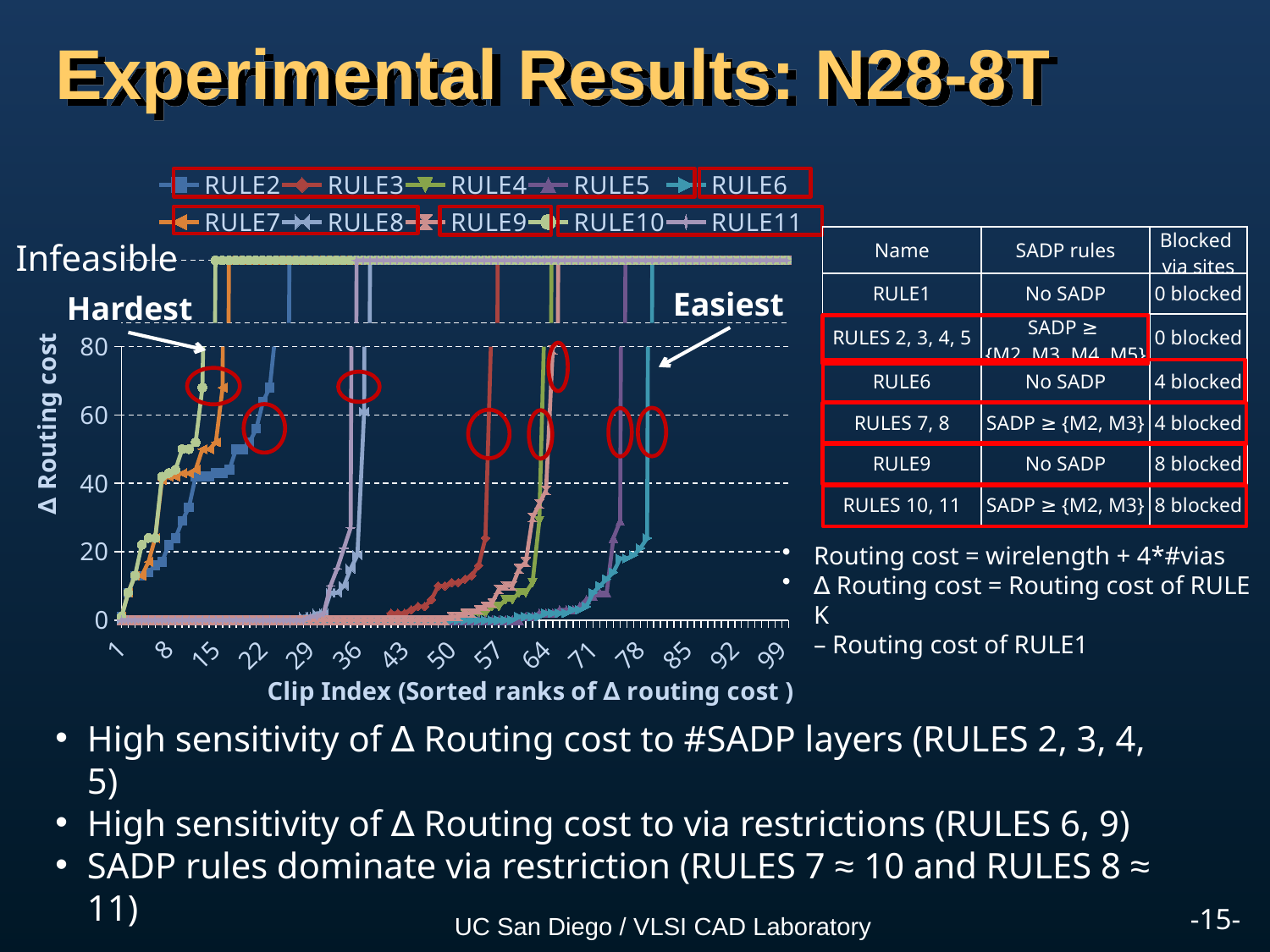
What kind of chart is shown on the slide? line chart Which series is listed last in the chart legend? RULE11 What is the last clip index label shown on the x axis? 99 What is the highest value labelled on the y axis of the chart? 80 What is the title of the chart's x axis? Clip Index (Sorted ranks of Δ routing cost ) What is the lowest value labelled on the y axis of the chart? 0 What is the first clip index label shown on the x axis? 1 How many tick labels are shown along the x axis of the chart? 15 What is the title of the chart's y axis? Δ Routing cost Which series is listed first in the chart legend? RULE2 How many series does the chart legend list? 10 Do the plotted Δ Routing cost values rise or fall as the clip index increases along the x axis? rise